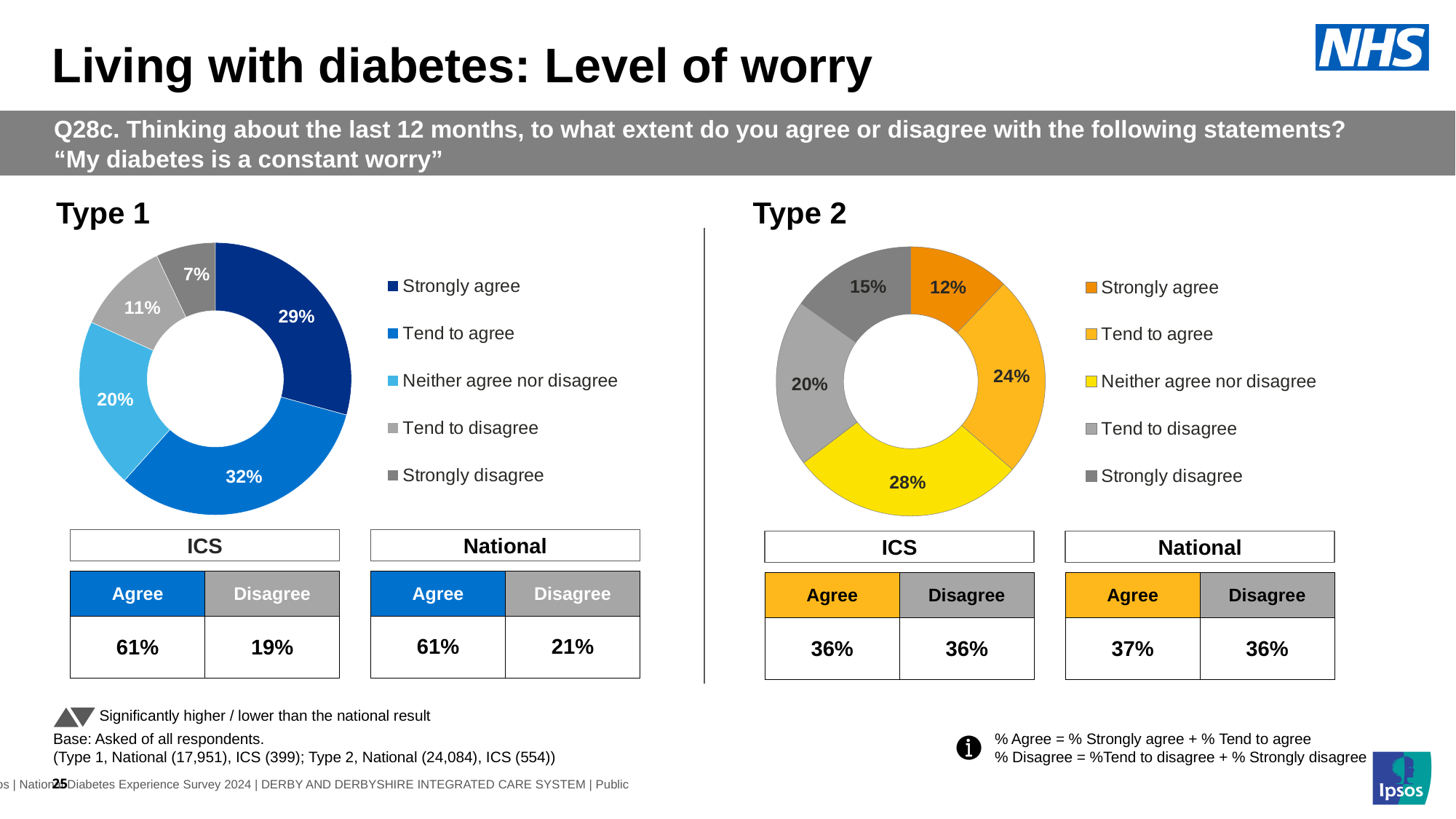
In the Type 2 chart, which category has the smallest share? Strongly agree What kind of chart is used for Type 2? Donut (pie) chart In the Type 2 chart, what colour is the Neither agree nor disagree slice? Yellow In the Type 2 chart, what percentage of respondents said they neither agree nor disagree? 28% In the Type 2 chart, which is larger: Tend to agree or Tend to disagree? Tend to agree In the Type 1 chart, which category has the largest share? Tend to agree In the Type 1 chart, what percentage of respondents said they strongly agree? 29% In the Type 1 chart, what is the difference between the Tend to agree and Strongly disagree shares? 25% In the Type 1 chart, what percentage of respondents said they tend to disagree? 11% In the Type 2 chart, what is the combined share of Strongly agree and Tend to agree? 36% In the Type 1 chart, which category has the smallest share? Strongly disagree How many categories does the Type 1 chart show? 5